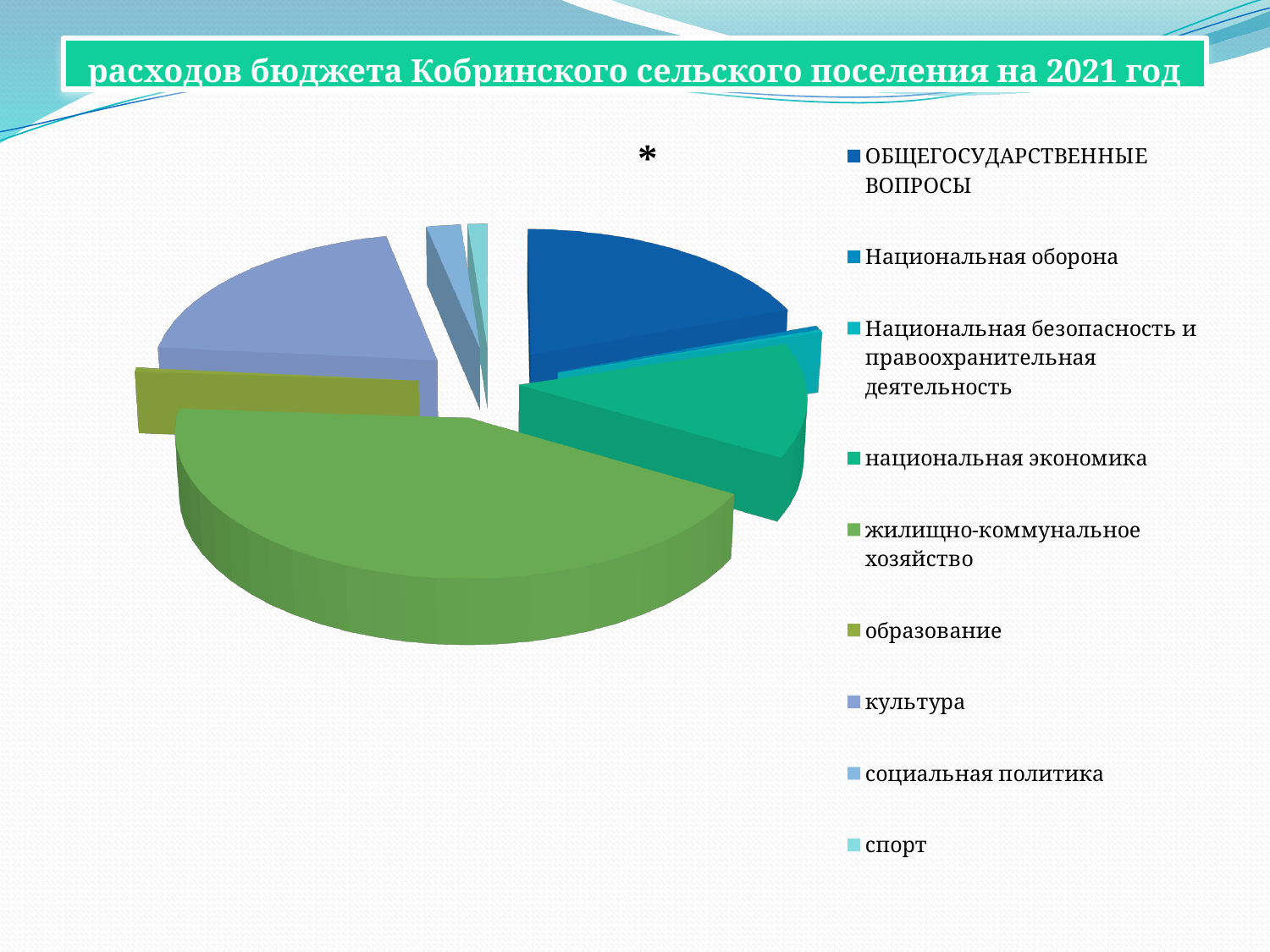
Which slice is larger: жилищно-коммунальное хозяйство or культура? жилищно-коммунальное хозяйство Which slice is larger: культура or спорт? культура Which slice is larger: ОБЩЕГОСУДАРСТВЕННЫЕ ВОПРОСЫ or образование? ОБЩЕГОСУДАРСТВЕННЫЕ ВОПРОСЫ What is the first category listed in the legend of the pie chart? ОБЩЕГОСУДАРСТВЕННЫЕ ВОПРОСЫ How many categories does the legend of the pie chart list? 9 What kind of chart is shown on the slide? pie chart What is the last category listed in the legend of the pie chart? спорт Which category has the largest slice of the pie chart? жилищно-коммунальное хозяйство